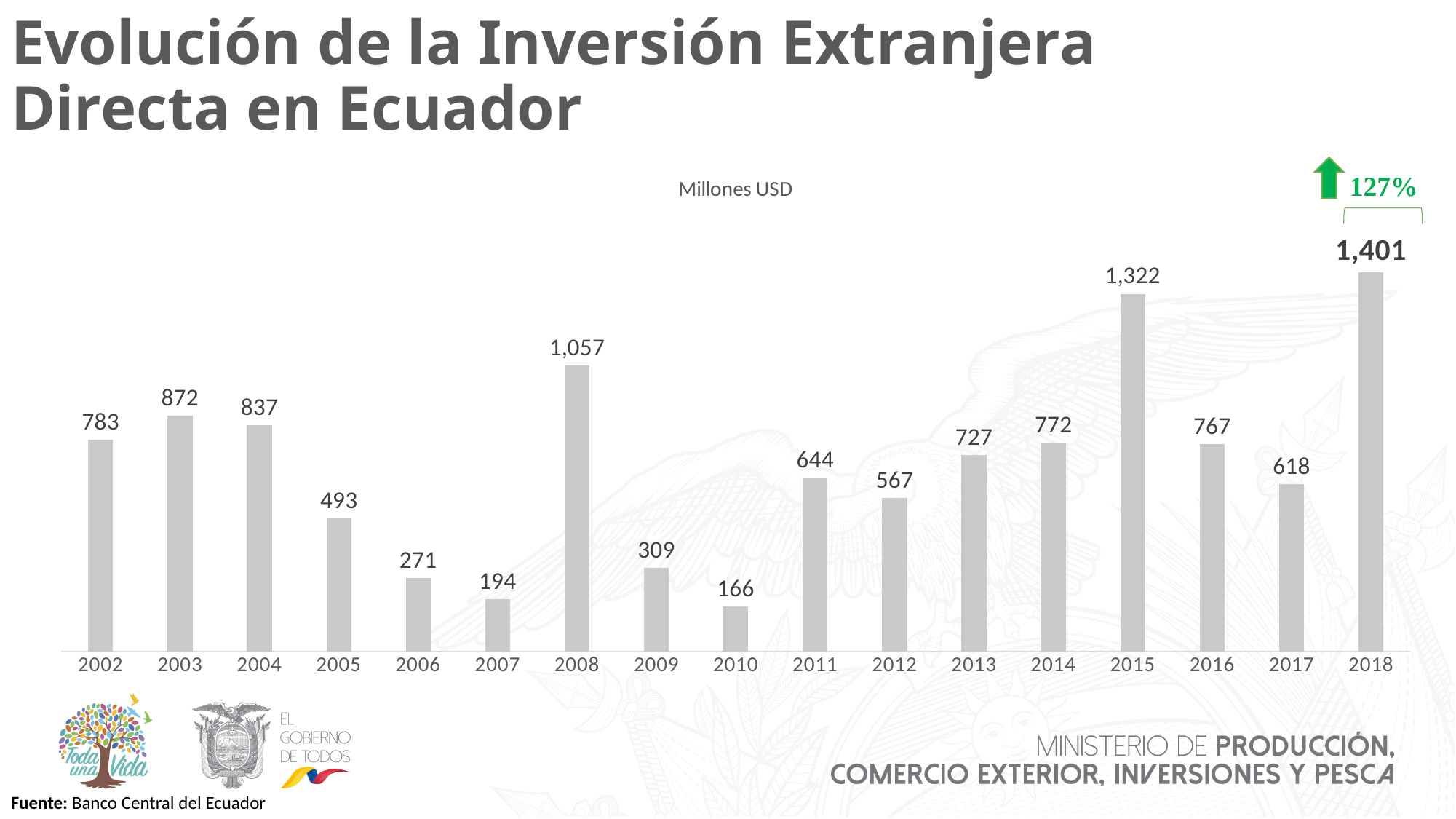
What is the difference between the values for 2003 and 2004? 35 What kind of chart is shown on the slide? bar chart What percentage increase is annotated above the 2018 bar? 127% Which year has the lowest value? 2010 What is the value for 2010? 166 What is the value for 2015? 1,322 How many years are shown on the x axis? 17 What unit is stated above the chart? Millones USD Which is larger, the value for 2013 or the value for 2014? 2014 What is the difference between the values for 2018 and 2017? 783 What is the value for 2008? 1,057 Which year has the highest value? 2018